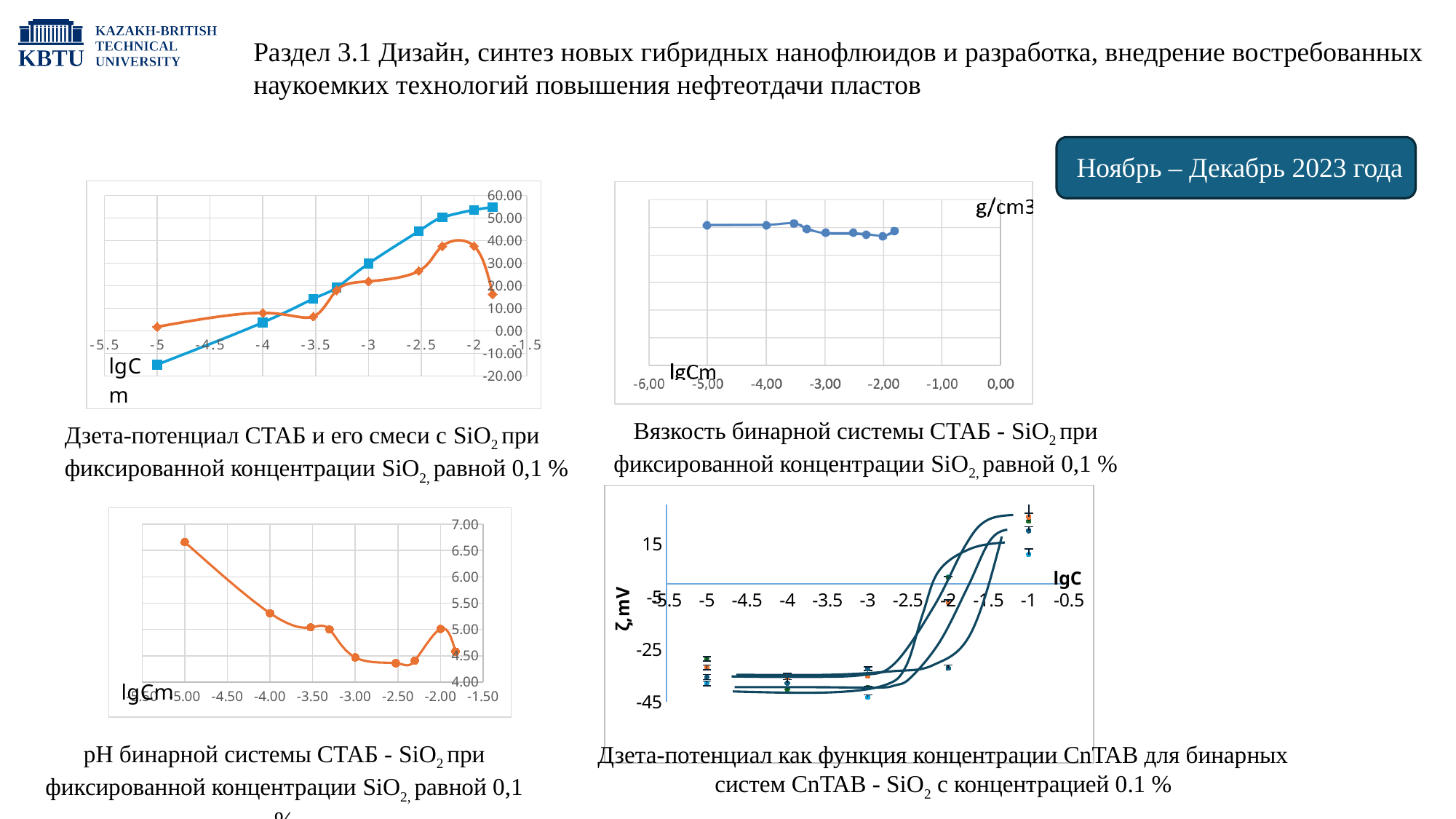
In the top-left chart (Дзета-потенциал СТАБ и его смеси с SiO2), is the value of the blue series at lgC = -2 greater or less than 50? greater In the top-left chart (Дзета-потенциал СТАБ и его смеси с SiO2), at lgC = -2, which series has the larger value, the blue or the orange one? blue In the top-right chart (Вязкость бинарной системы СТАБ - SiO2), how many data series are plotted? 1 In the top-left chart (Дзета-потенциал СТАБ и его смеси с SiO2), does the blue series rise or fall as lgC increases from -5 to -2? rise In the bottom-left chart (pH бинарной системы СТАБ - SiO2), at which lgCm value is the pH highest? -5.00 In the bottom-left chart (pH бинарной системы СТАБ - SiO2), is the value at lgCm = -5.00 greater or less than 6.50? greater In the bottom-right chart (Дзета-потенциал как функция концентрации CnTAB), what is the label of the vertical axis? ζ, mV In the top-right chart (Вязкость бинарной системы СТАБ - SiO2), what unit is written in the upper right corner of the plot area? g/cm3 What kind of chart is the top-left chart (Дзета-потенциал СТАБ и его смеси с SiO2)? line chart In the bottom-left chart (pH бинарной системы СТАБ - SiO2), is the value at lgCm = -4.00 greater or less than 5.50? less In the top-left chart (Дзета-потенциал СТАБ и его смеси с SiO2), how many data series are plotted? 2